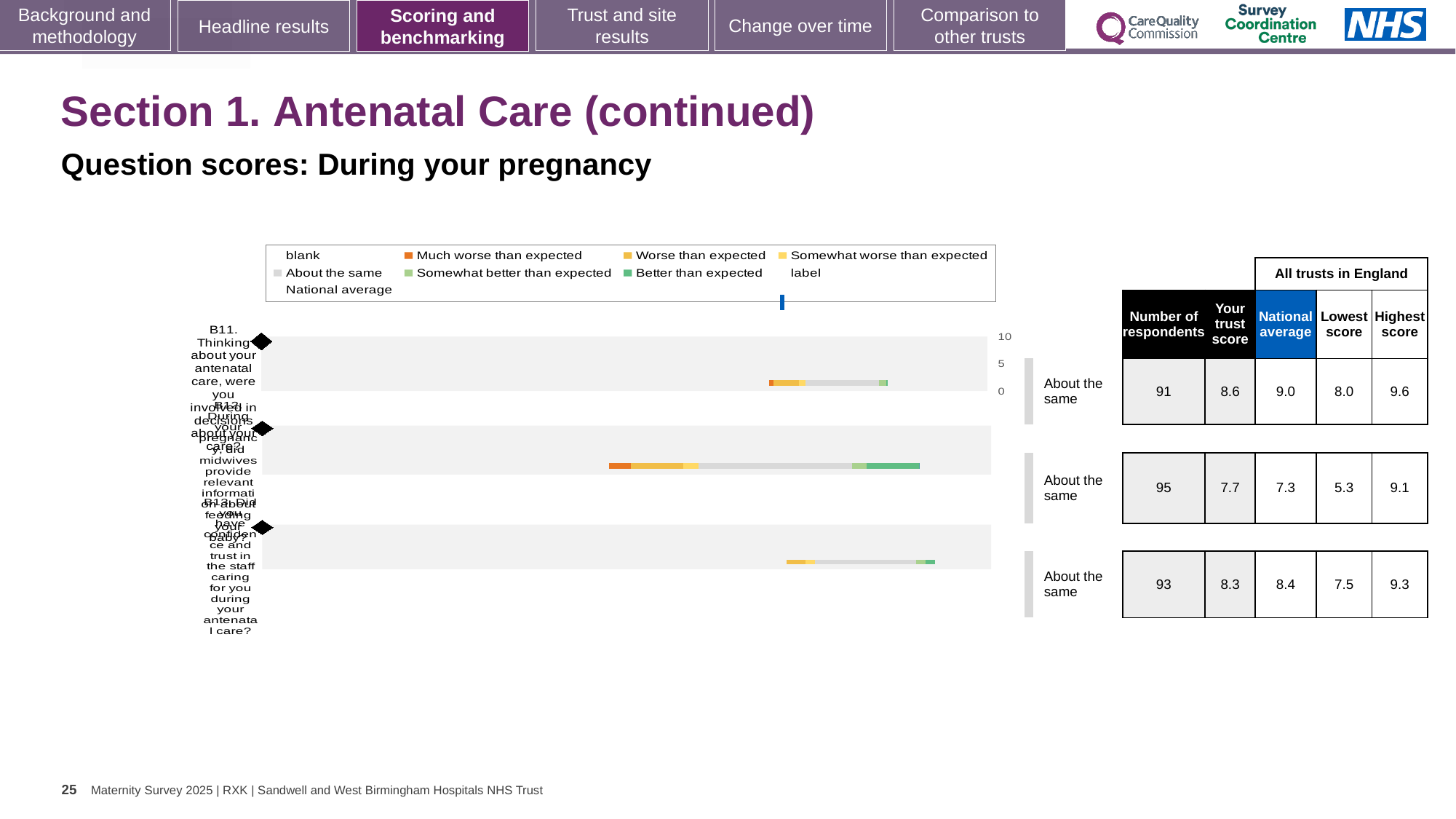
For question B13, which is larger: the trust score or the national average? National average How many respondents answered question B13 (confidence and trust in the staff caring for you)? 93 What is the trust score for question B11 (involved in decisions about your care)? 8.6 What benchmark category is shown for question B11? About the same What kind of chart is shown on the slide? Bar chart Which question has the highest trust score? B11 What is the difference between the national average and the trust score for question B11? 0.4 What is the subtitle describing the chart's content? Question scores: During your pregnancy What is the difference between the highest score and the lowest score for question B12? 3.8 Which question has the lowest 'Lowest score' across all trusts in England? B12 What is the national average for question B12 (midwives provide relevant information about feeding your baby)? 7.3 How many questions (categories) are plotted in the chart? 3